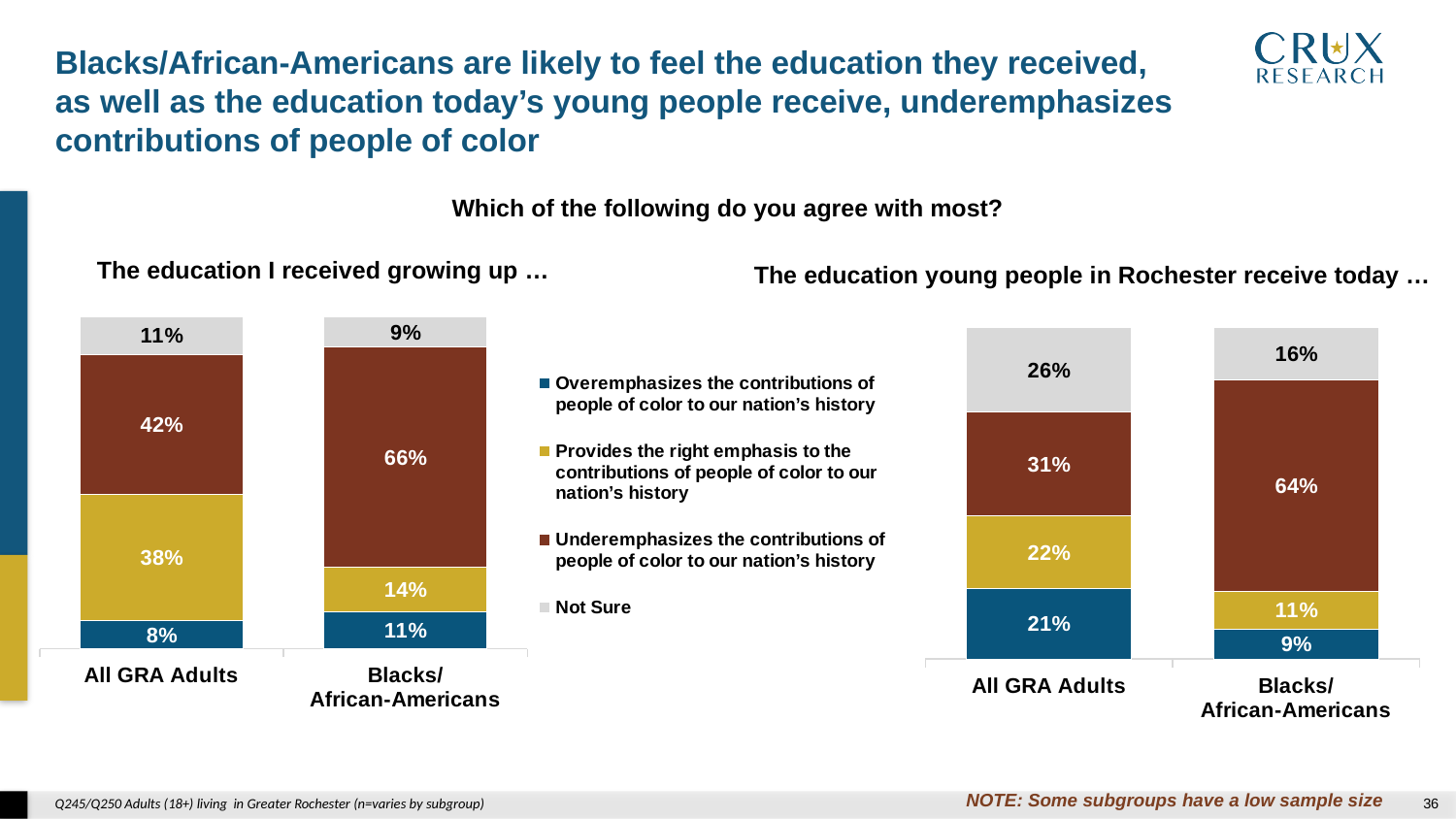
In the chart titled "The education young people in Rochester receive today …", what is the total of the All GRA Adults stacked bar? 100% In the chart titled "The education I received growing up …", which group has the larger share saying the education provides the right emphasis: All GRA Adults or Blacks/African-Americans? All GRA Adults In the chart titled "The education young people in Rochester receive today …", which response has the highest share among Blacks/African-Americans? Underemphasizes the contributions of people of color to our nation's history In the chart titled "The education young people in Rochester receive today …", what percentage of All GRA Adults are Not Sure? 26% In the chart titled "The education I received growing up …", what is the difference between the Blacks/African-Americans and All GRA Adults values for "Underemphasizes the contributions of people of color to our nation's history"? 24 percentage points In the chart titled "The education I received growing up …", what percentage of All GRA Adults say the education underemphasizes the contributions of people of color? 42% In the chart titled "The education I received growing up …", which response has the lowest share among All GRA Adults? Overemphasizes the contributions of people of color to our nation's history In the chart titled "The education young people in Rochester receive today …", what percentage of Blacks/African-Americans say the education overemphasizes the contributions of people of color? 9% In the chart titled "The education I received growing up …", what percentage of Blacks/African-Americans say the education underemphasizes the contributions of people of color? 66% What type of chart is used on this slide? Stacked bar chart In the chart titled "The education young people in Rochester receive today …", what is the difference between the All GRA Adults and Blacks/African-Americans values for "Provides the right emphasis"? 11 percentage points How many series does the legend list? 4